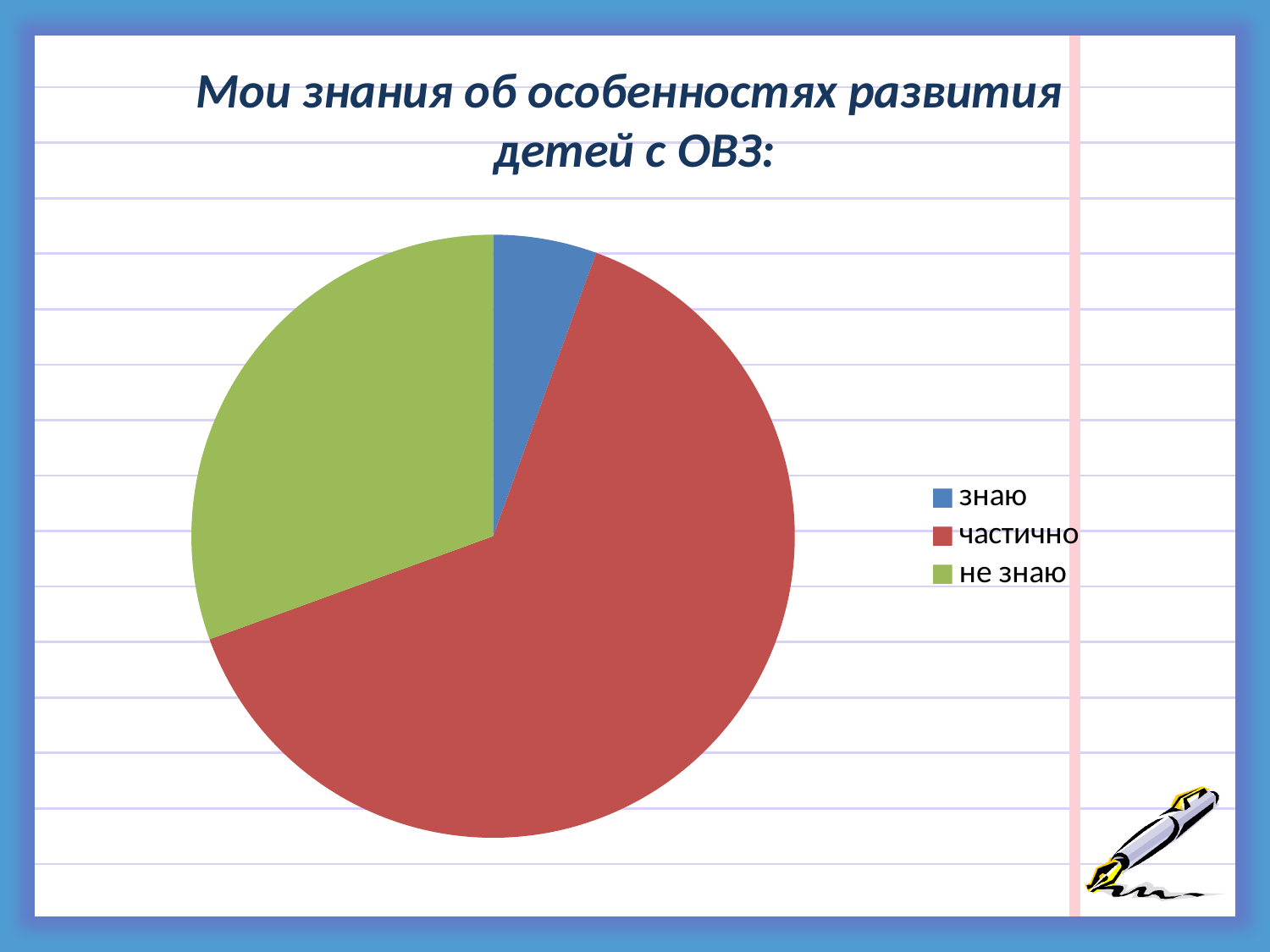
What colour is the slice for "не знаю"? green What kind of chart is shown on the slide? pie chart What is the title of the chart? Мои знания об особенностях развития детей с ОВЗ: Which slice is larger, "не знаю" or "знаю"? не знаю Which category has the smallest slice of the pie? знаю Which slice is larger, "частично" or "не знаю"? частично How many entries does the legend list? 3 Which category has the largest slice of the pie? частично How many slices does the pie chart have? 3